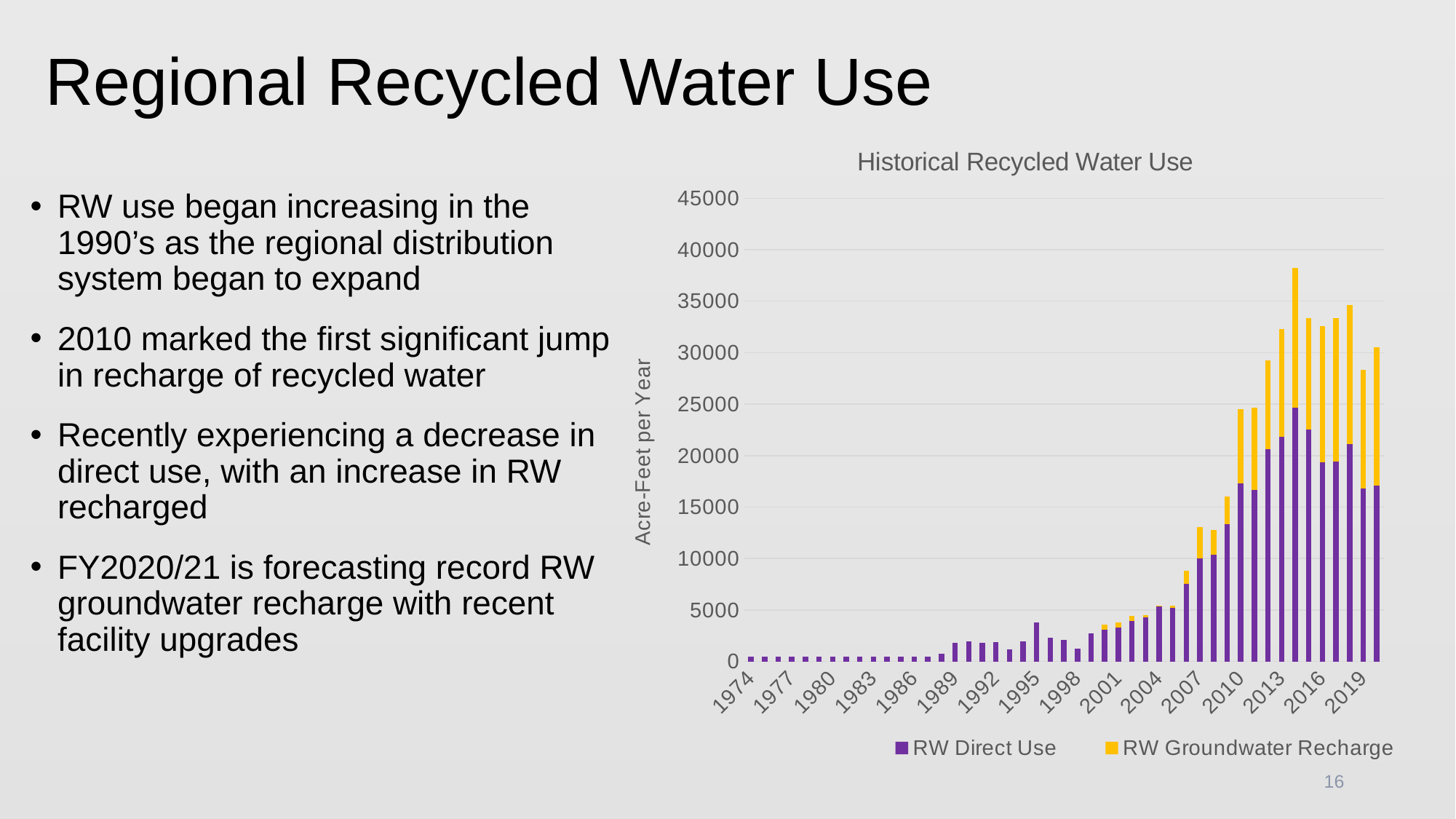
How many series does the chart's legend list? 2 Is the total recycled water use for 1974 greater or less than 5000? less What is the title of the chart? Historical Recycled Water Use Which year has the larger total recycled water use, 2001 or 2010? 2010 Do total recycled water use values generally rise or fall from 1974 to 2016? rise What kind of chart is shown on the slide? bar chart Which colour represents RW Groundwater Recharge in the chart? yellow Is the total recycled water use for 2016 greater or less than 30000? greater Which year has the larger RW Direct Use value, 1995 or 1998? 1995 Is the total recycled water use for 2019 greater or less than 25000? greater